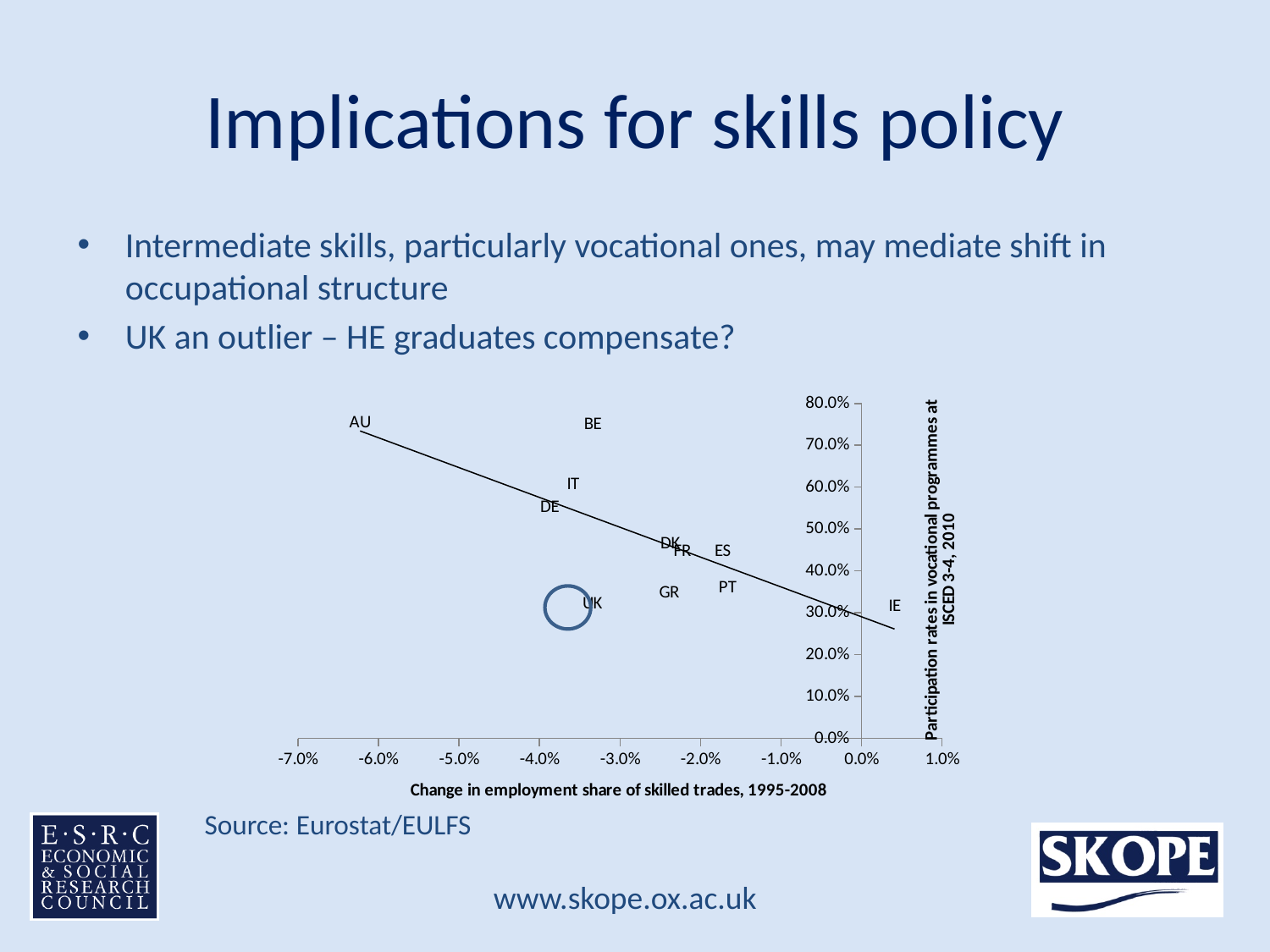
What kind of chart is shown on the slide? scatter chart How many countries are plotted on the chart? 11 Is the change in employment share of skilled trades for AU greater or less than -5.0%? less Is the participation rate in vocational programmes for UK greater or less than 40.0%? less Which country has the highest change in employment share of skilled trades? IE Is the participation rate in vocational programmes for DE greater or less than 40.0%? greater Which country is circled on the chart? UK What is the title of the horizontal axis? Change in employment share of skilled trades, 1995-2008 Which has a higher participation rate in vocational programmes, BE or PT? BE Which country has the lowest (most negative) change in employment share of skilled trades? AU Does the trend line rise or fall as the change in employment share increases along the x axis? fall